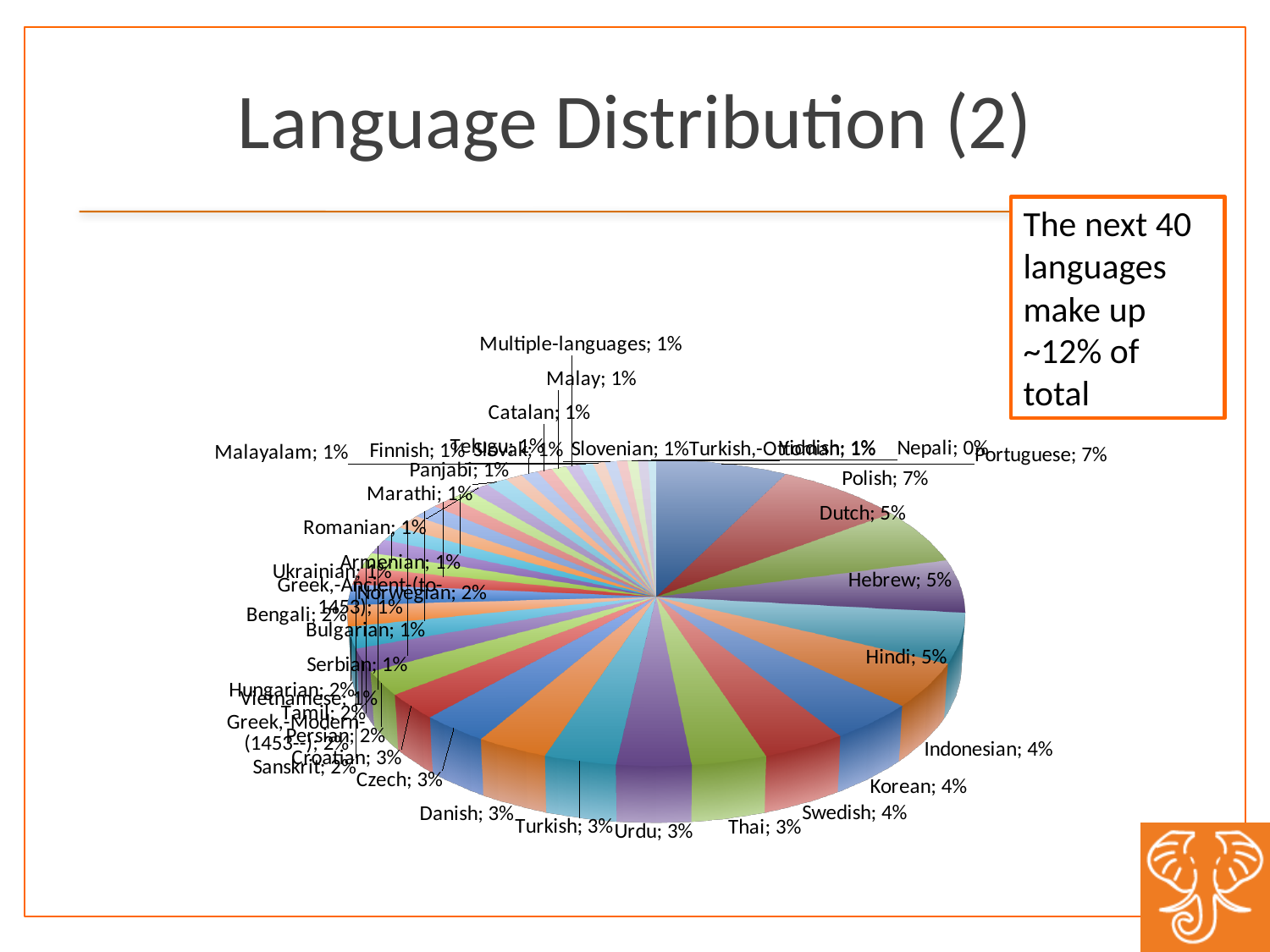
What percentage is shown for Indonesian? 4% What percentage is shown for Nepali? 0% What share of the pie does Portuguese have? 7% What percentage is shown for Polish? 7% Which has the larger share, Dutch or Korean? Dutch Which language has the smallest labelled share in the pie? Nepali What percentage is shown for Hindi? 5% According to the text box on the slide, roughly what share of the total do the next 40 languages make up? ~12% What percentage is shown for Czech? 3% What kind of chart is shown on the slide? pie chart What is the difference in percentage points between Portuguese and Hebrew? 2 What is the title of the chart on the slide? Language Distribution (2)